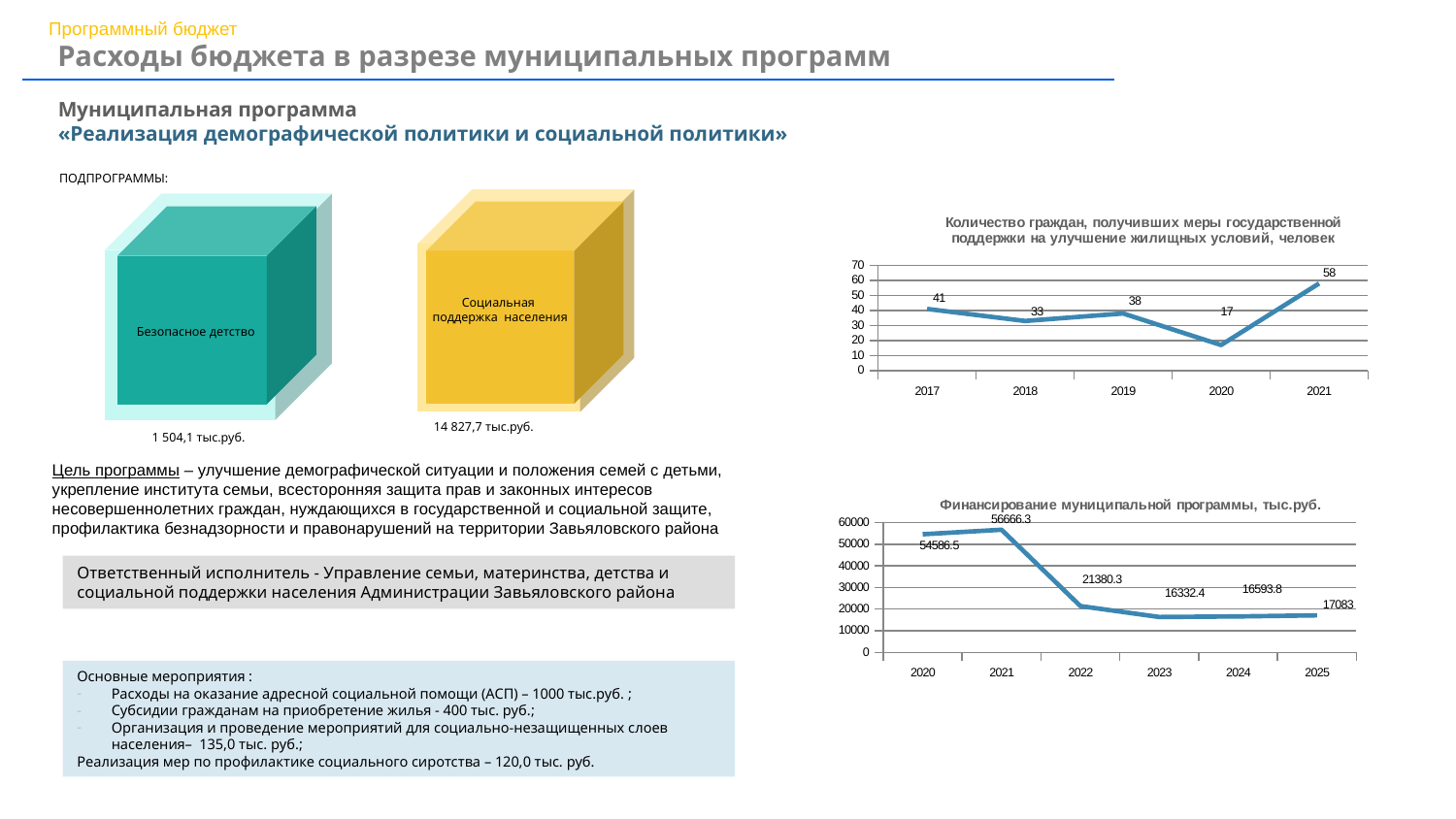
На графике «Количество граждан, получивших меры государственной поддержки на улучшение жилищных условий, человек» в каком году значение наибольшее? 2021 На графике «Финансирование муниципальной программы, тыс.руб.» значение за 2022 год больше или меньше 30000? меньше На графике «Количество граждан, получивших меры государственной поддержки на улучшение жилищных условий, человек» какое значение указано для 2020 года? 17 На графике «Количество граждан, получивших меры государственной поддержки на улучшение жилищных условий, человек» в каком году значение наименьшее? 2020 На графике «Финансирование муниципальной программы, тыс.руб.» какое значение указано для 2021 года? 56666.3 На графике «Финансирование муниципальной программы, тыс.руб.» значения в целом растут или снижаются с 2020 по 2025 год? снижаются На графике «Количество граждан, получивших меры государственной поддержки на улучшение жилищных условий, человек» на сколько значение 2021 года больше значения 2017 года? 17 На графике «Количество граждан, получивших меры государственной поддержки на улучшение жилищных условий, человек» какое значение больше: за 2018 или за 2019 год? 2019 На графике «Финансирование муниципальной программы, тыс.руб.» в каком году значение наименьшее? 2023 Какого типа график «Финансирование муниципальной программы, тыс.руб.»? линейный график На графике «Финансирование муниципальной программы, тыс.руб.» какое значение указано для 2025 года? 17083 На графике «Количество граждан, получивших меры государственной поддержки на улучшение жилищных условий, человек» сколько лет показано на оси x? 5